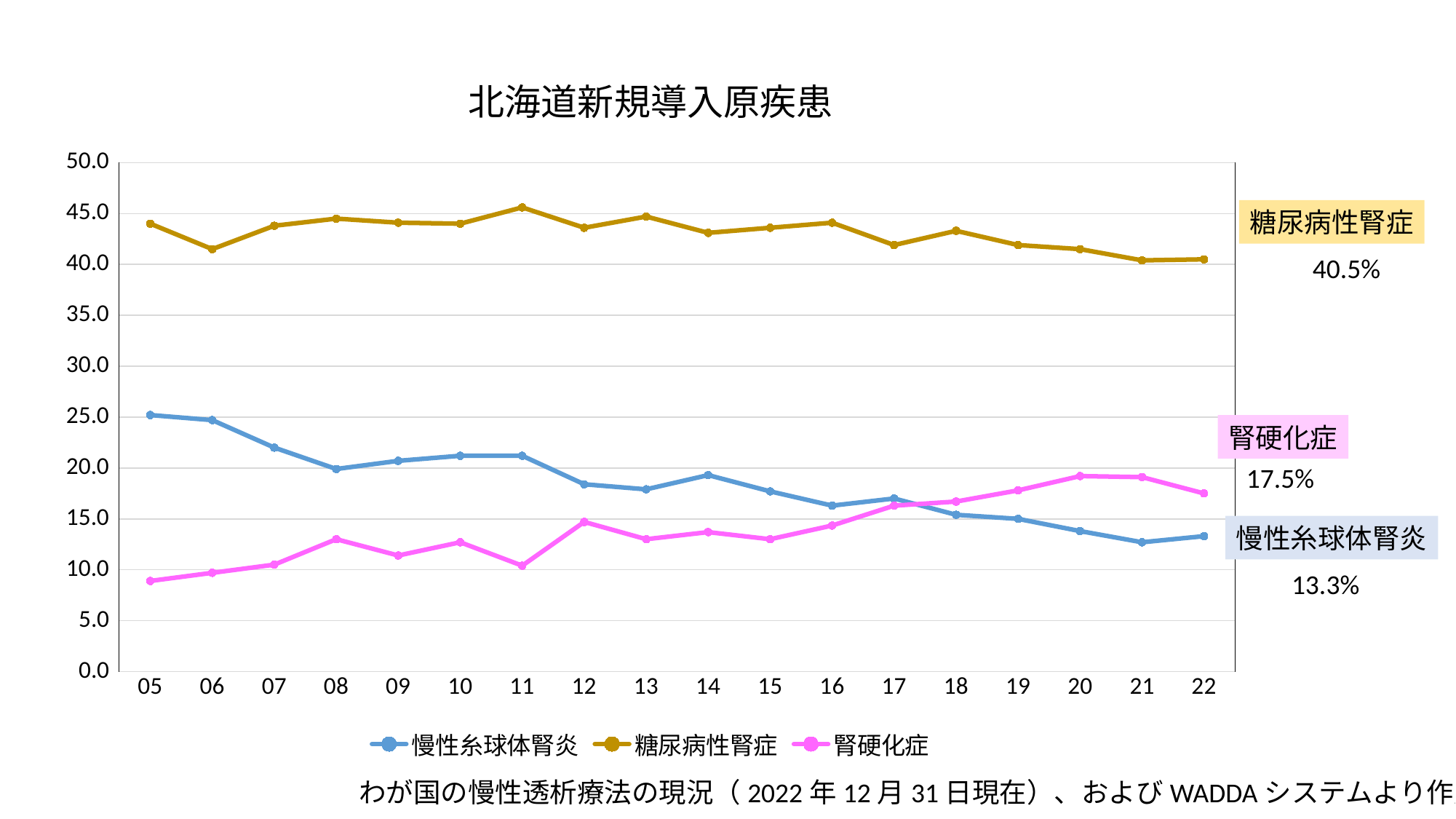
How many series does the legend list? 3 Which series has the highest values across all years? 糖尿病性腎症 What is the difference between 腎硬化症 and 慢性糸球体腎炎 in 22? 4.2% What is the value for 慢性糸球体腎炎 in 22? 13.3% What is the value for 糖尿病性腎症 in 22? 40.5% Is the value for 腎硬化症 in 05 greater or less than 10.0? less In 22, which is larger, 腎硬化症 or 慢性糸球体腎炎? 腎硬化症 What is the difference between 糖尿病性腎症 and 腎硬化症 in 22? 23.0% Does the value for 慢性糸球体腎炎 rise or fall from 05 to 22? fall What is the value for 腎硬化症 in 22? 17.5% How many years are plotted along the x axis? 18 What kind of chart is shown on the slide? line chart